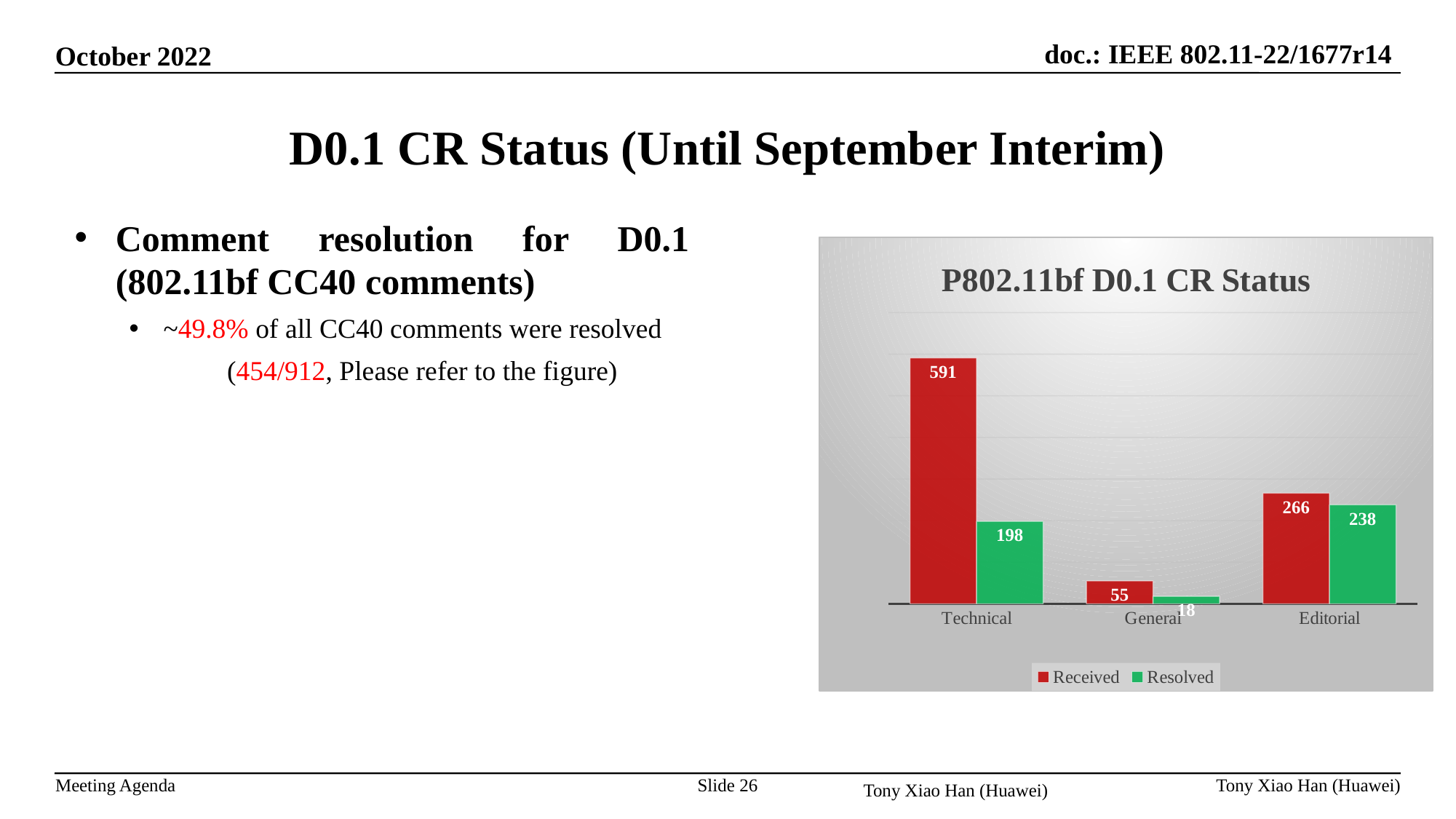
What is the Resolved value for Editorial? 238 Which is larger for Editorial, Received or Resolved? Received How many categories are shown on the x axis? 3 What is the difference between Received and Resolved for Technical? 393 What is the Resolved value for General? 18 How many series does the legend list? 2 What kind of chart is shown? Bar chart Which category has the lowest Resolved value? General What is the title of the chart? P802.11bf D0.1 CR Status What is the Received value for General? 55 What is the Received value for Technical? 591 Which category has the highest Received value? Technical